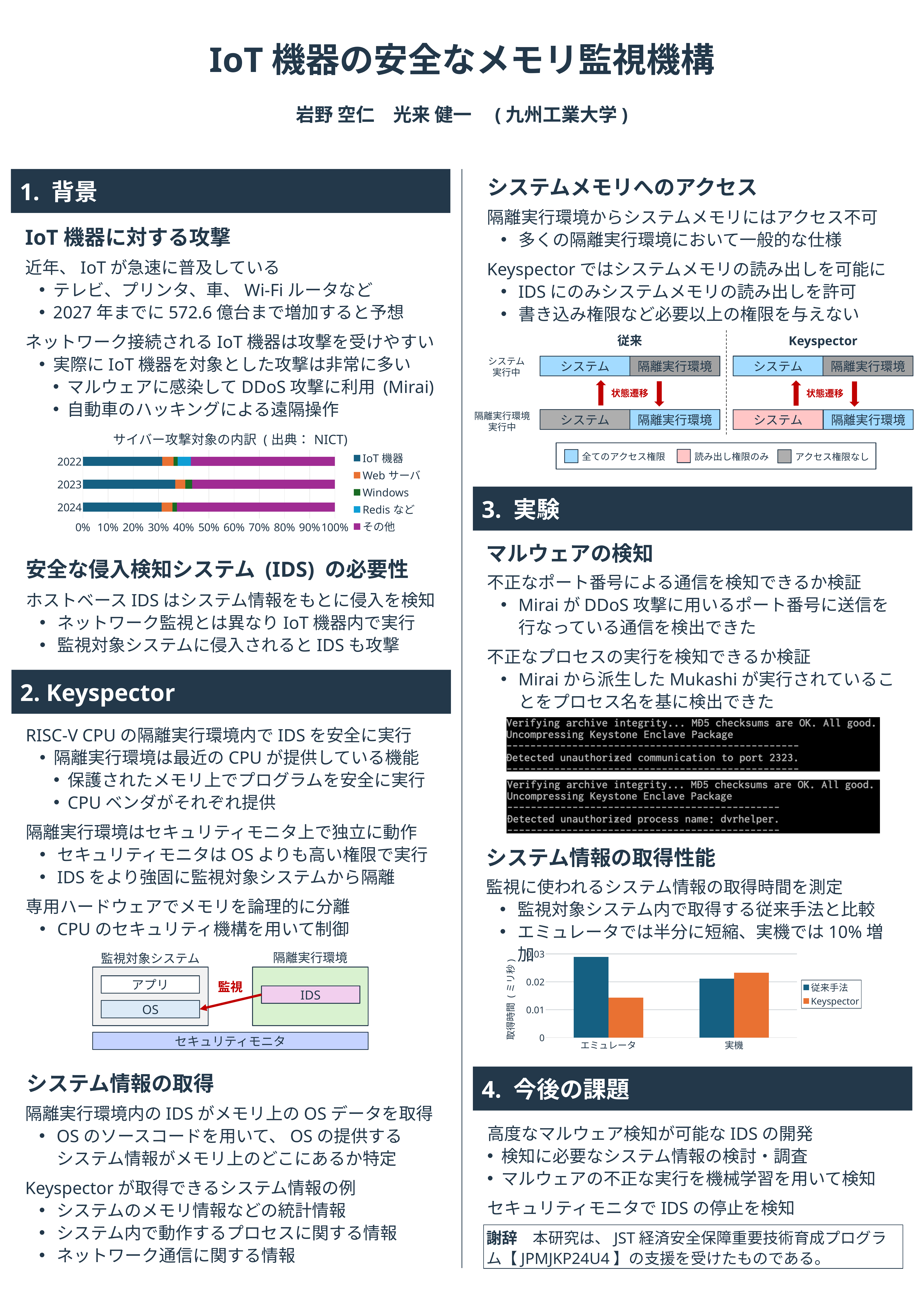
In the chart titled サイバー攻撃対象の内訳（出典：NICT）, how many series does the legend list? 5 In the chart titled サイバー攻撃対象の内訳（出典：NICT）, which series has the largest share in 2023? その他 In the chart titled サイバー攻撃対象の内訳（出典：NICT）, is the share of IoT 機器 in 2022 greater or less than 40%? less In the chart titled サイバー攻撃対象の内訳（出典：NICT）, how many years are shown on the vertical axis? 3 What kind of chart is the chart titled サイバー攻撃対象の内訳（出典：NICT）? bar chart In the chart under the heading システム情報の取得性能, is the value of 従来手法 for エミュレータ greater or less than 0.02? greater What kind of chart is the chart under the heading システム情報の取得性能? bar chart In the chart under the heading システム情報の取得性能, is the value of Keyspector for エミュレータ greater or less than 0.02? less In the chart under the heading システム情報の取得性能, which series has the larger value for エミュレータ, 従来手法 or Keyspector? 従来手法 In the chart under the heading システム情報の取得性能, how many series does the legend list? 2 In the chart titled サイバー攻撃対象の内訳（出典：NICT）, which series is listed first in the legend? IoT 機器